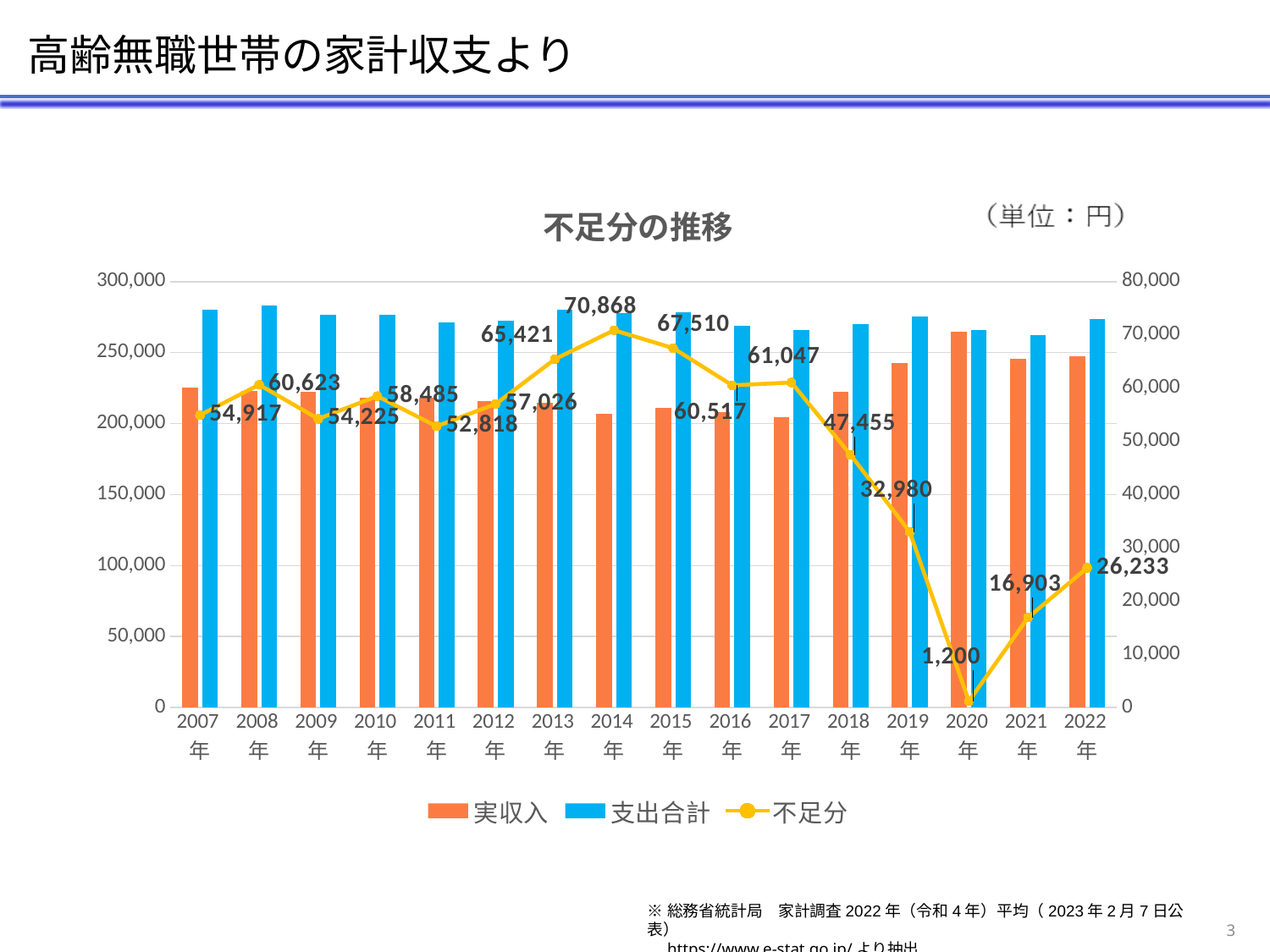
Which year has a larger 不足分 value, 2008年 or 2009年? 2008年 What is the value of 不足分 for 2014年? 70,868 What is the value of 不足分 for 2022年? 26,233 How many years are shown on the x axis? 16 What is the value of 不足分 for 2020年? 1,200 Does the 不足分 line rise or fall from 2014年 to 2020年? fall In which year is 不足分 highest? 2014年 How many series does the legend list? 3 In which year is 不足分 lowest? 2020年 What kind of chart is this? Combination bar and line chart Is the 実収入 value for 2020年 greater or less than 250,000? greater What is the difference between the 不足分 values for 2022年 and 2021年? 9,330